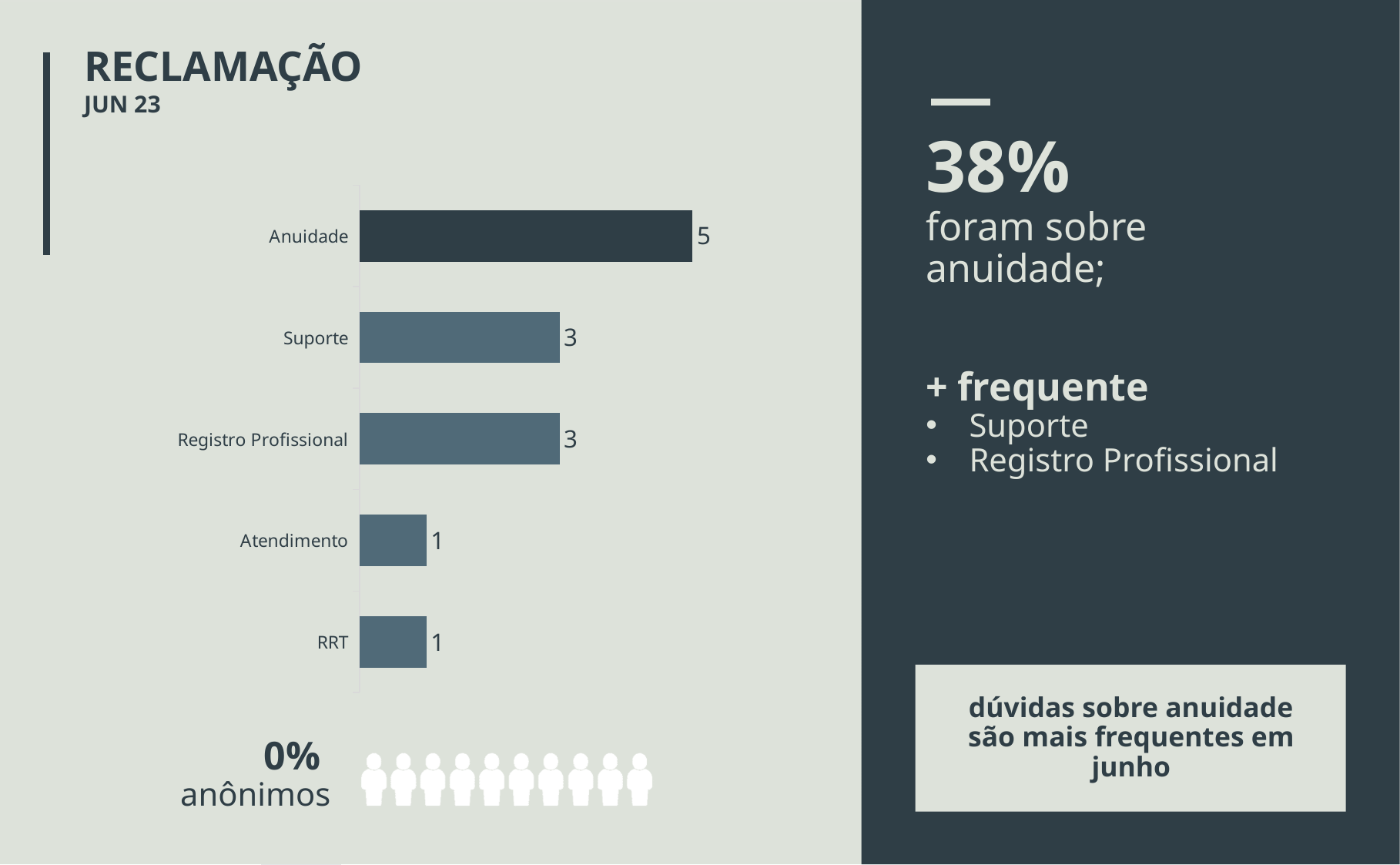
What is the value for RRT? 1 What is the value for Registro Profissional? 3 What is the value for Suporte? 3 What is the value for Atendimento? 1 How many categories are shown in the chart? 5 What is the difference between the values for Anuidade and Suporte? 2 Which is larger, the value for Anuidade or the value for Atendimento? Anuidade What kind of chart is shown on the slide? Bar chart Which bar is drawn in a darker colour than the others? Anuidade What is the value for Anuidade? 5 What is the difference between the values for Registro Profissional and RRT? 2 Which category has the highest value? Anuidade